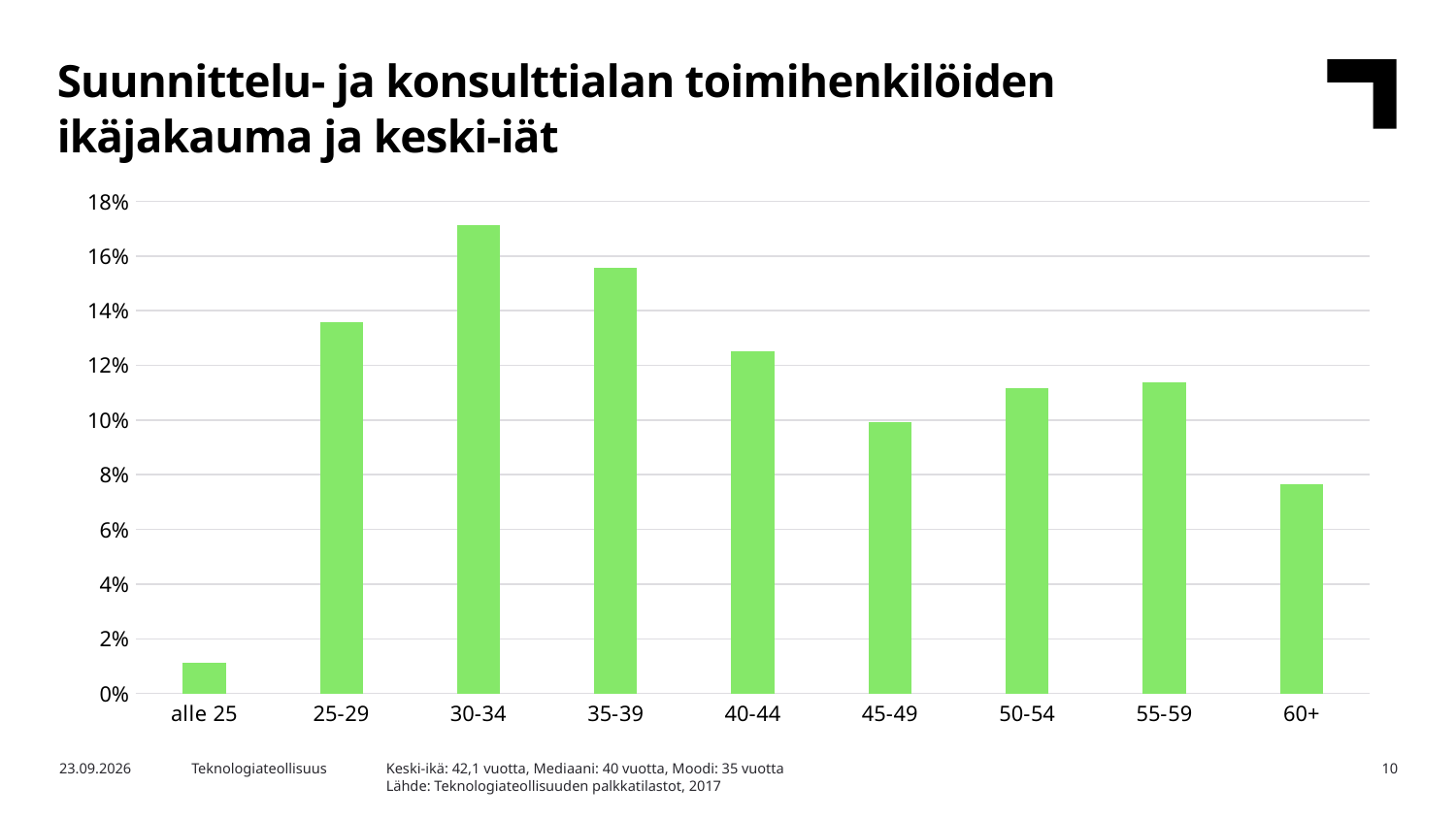
What kind of chart is shown on the slide? bar chart Do the values rise or fall from 30-34 to 45-49? fall Which age group has the lowest share? alle 25 Is the value for alle 25 greater or less than 2%? less Which is larger, the value for 35-39 or the value for 40-44? 35-39 What is the title of the chart on the slide? Suunnittelu- ja konsulttialan toimihenkilöiden ikäjakauma ja keski-iät Which age group has the highest share? 30-34 Which is larger, the value for 45-49 or the value for 60+? 45-49 Is the value for 25-29 greater or less than 12%? greater How many age categories are shown on the x axis? 9 Is the value for 60+ greater or less than 8%? less